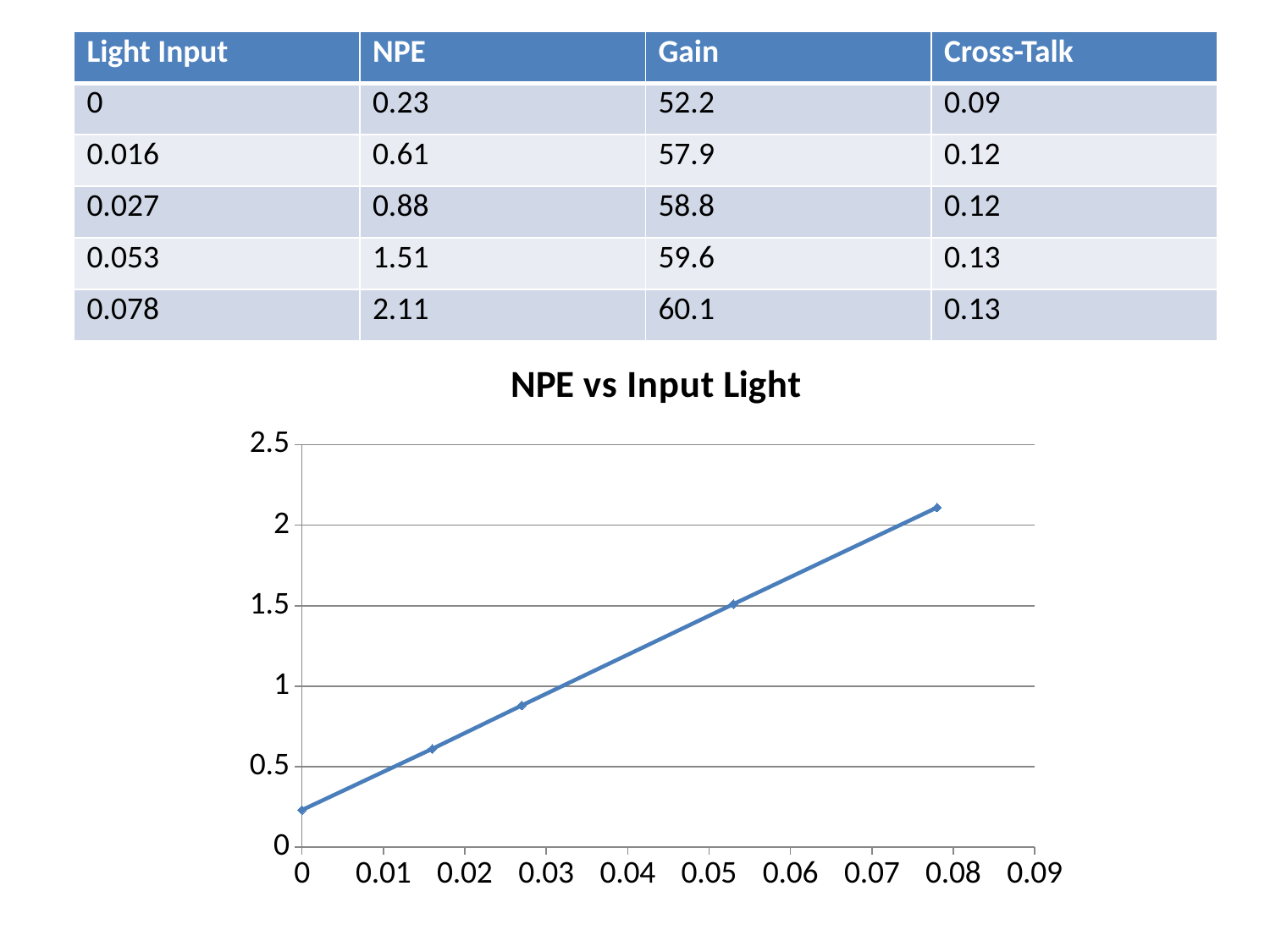
What is the difference in NPE between light input 0.078 and light input 0? 1.88 What kind of chart is shown under the title "NPE vs Input Light"? line chart What is the NPE value at a light input of 0.053? 1.51 What is the NPE value at a light input of 0.078? 2.11 What is the NPE value at a light input of 0? 0.23 Which has a larger NPE: light input 0.027 or light input 0.016? 0.027 At which light input is NPE highest? 0.078 Is the NPE value at light input 0.053 greater or less than 1? greater How many data points are plotted on the NPE vs Input Light chart? 5 What is the title of the chart? NPE vs Input Light At which light input is NPE lowest? 0 Does NPE rise or fall as Input Light increases along the x axis? rise